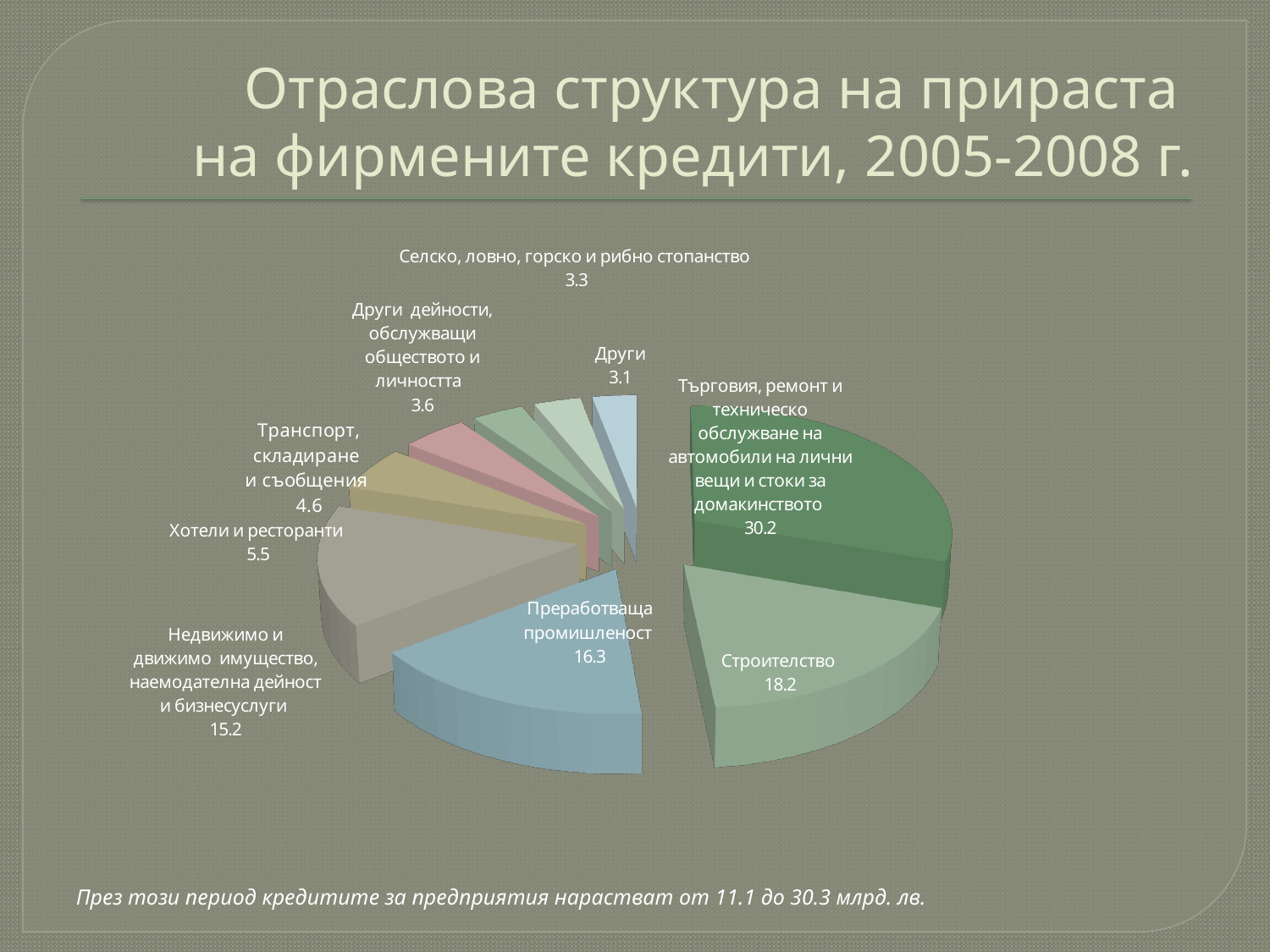
What is the difference between the values for Селско, ловно, горско и рибно стопанство and Други? 0.2 What is the difference between the values for Строителство and Преработваща промишленост? 1.9 What is the value for Преработваща промишленост? 16.3 What is the value for Строителство? 18.2 Which category has the smallest slice of the pie? Други What type of chart is shown on the slide? Pie chart Which is larger: the value for Недвижимо и движимо имущество, наемодателна дейност и бизнесуслуги or the value for Хотели и ресторанти? Недвижимо и движимо имущество, наемодателна дейност и бизнесуслуги What is the value for Хотели и ресторанти? 5.5 How many categories are shown in the pie chart? 9 What is the title of the chart on the slide? Отраслова структура на прираста на фирмените кредити, 2005-2008 г. Which category has the largest slice of the pie? Търговия, ремонт и техническо обслужване на автомобили на лични вещи и стоки за домакинството What is the value for Транспорт, складиране и съобщения? 4.6